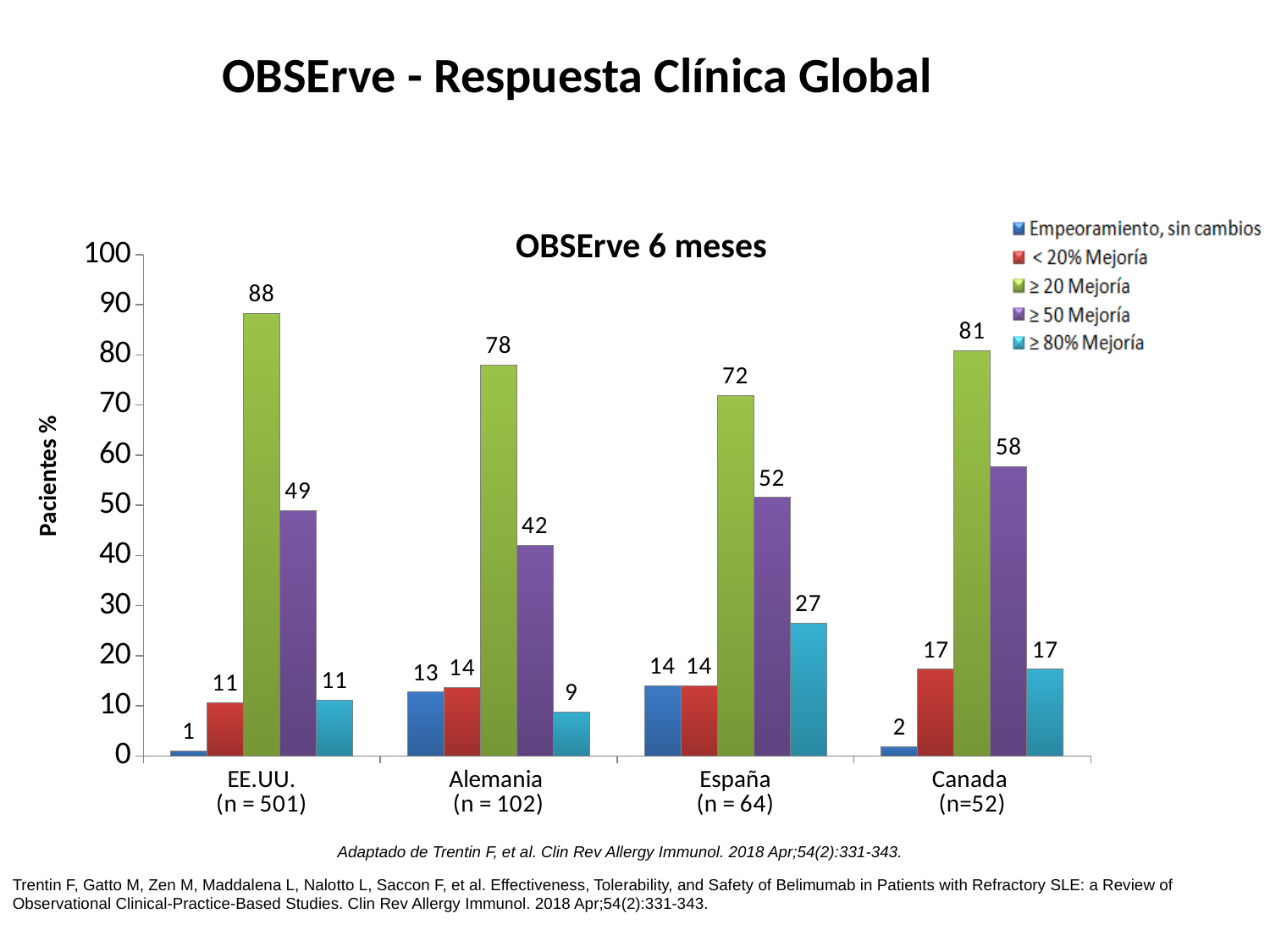
How many series does the legend list? 5 How many countries are shown on the x axis? 4 What is the value for ≥ 20 Mejoría in EE.UU. (n = 501)? 88 What kind of chart is shown? Bar chart What is the value for Empeoramiento, sin cambios in Alemania (n = 102)? 13 Which country has the lowest value for ≥ 80% Mejoría? Alemania Which country has the highest value for ≥ 20 Mejoría? EE.UU. Which is larger: the ≥ 20 Mejoría value for Alemania or for España? Alemania What is the value for ≥ 50 Mejoría in Canada (n=52)? 58 What is the difference between the ≥ 50 Mejoría values for Canada and EE.UU.? 9 What is the value for ≥ 80% Mejoría in España (n = 64)? 27 What is the title of the chart? OBSErve 6 meses